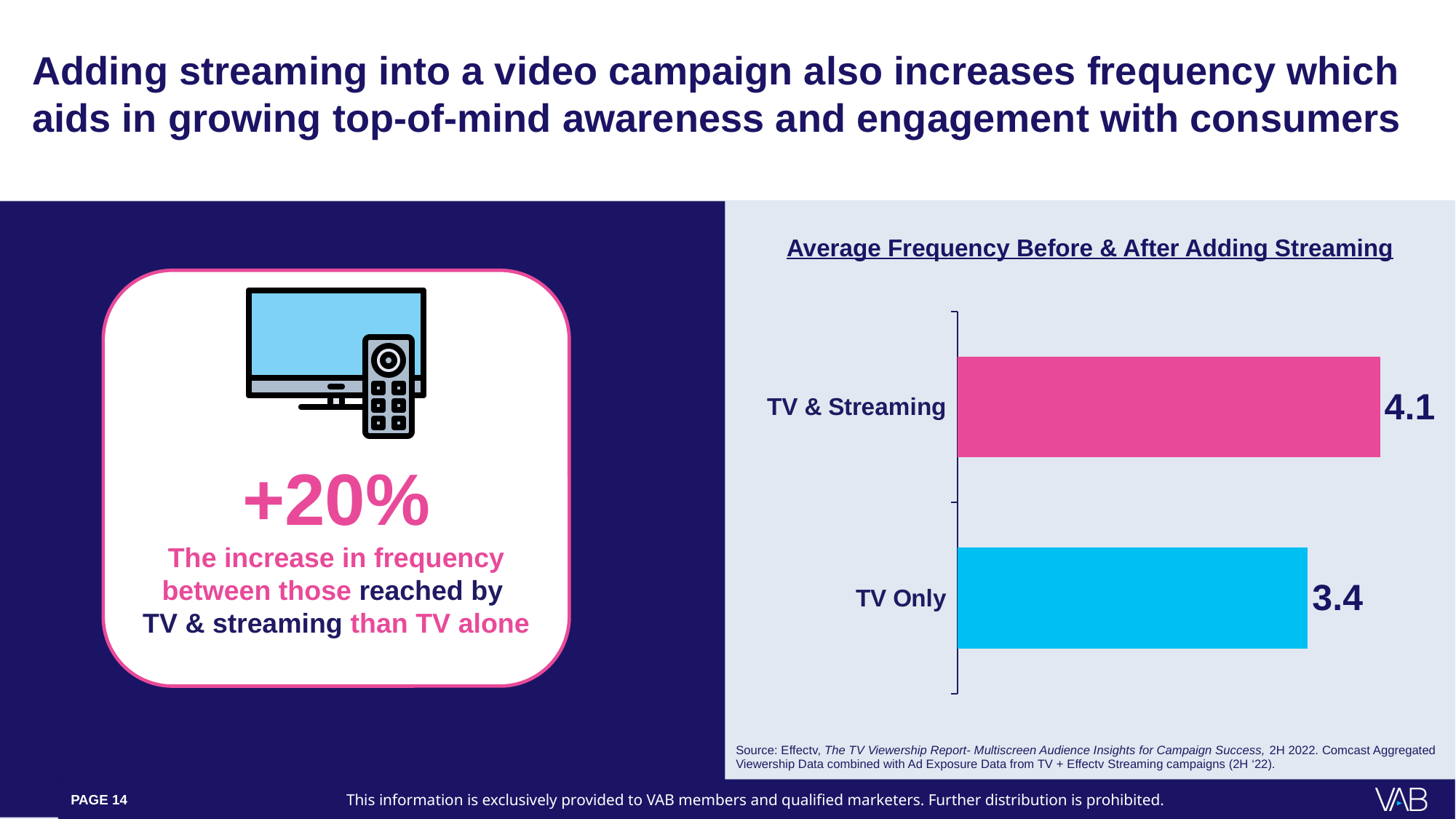
What is the title of the chart? Average Frequency Before & After Adding Streaming Which category has the higher average frequency? TV & Streaming What colour is the TV Only bar? light blue Is the average frequency for TV Only larger or smaller than for TV & Streaming? smaller What is the average frequency for TV & Streaming? 4.1 How many categories are shown in the chart? 2 Which category has the lower average frequency? TV Only What kind of chart is shown on the slide? bar chart What is the average frequency for TV Only? 3.4 What is the difference in average frequency between TV & Streaming and TV Only? 0.7